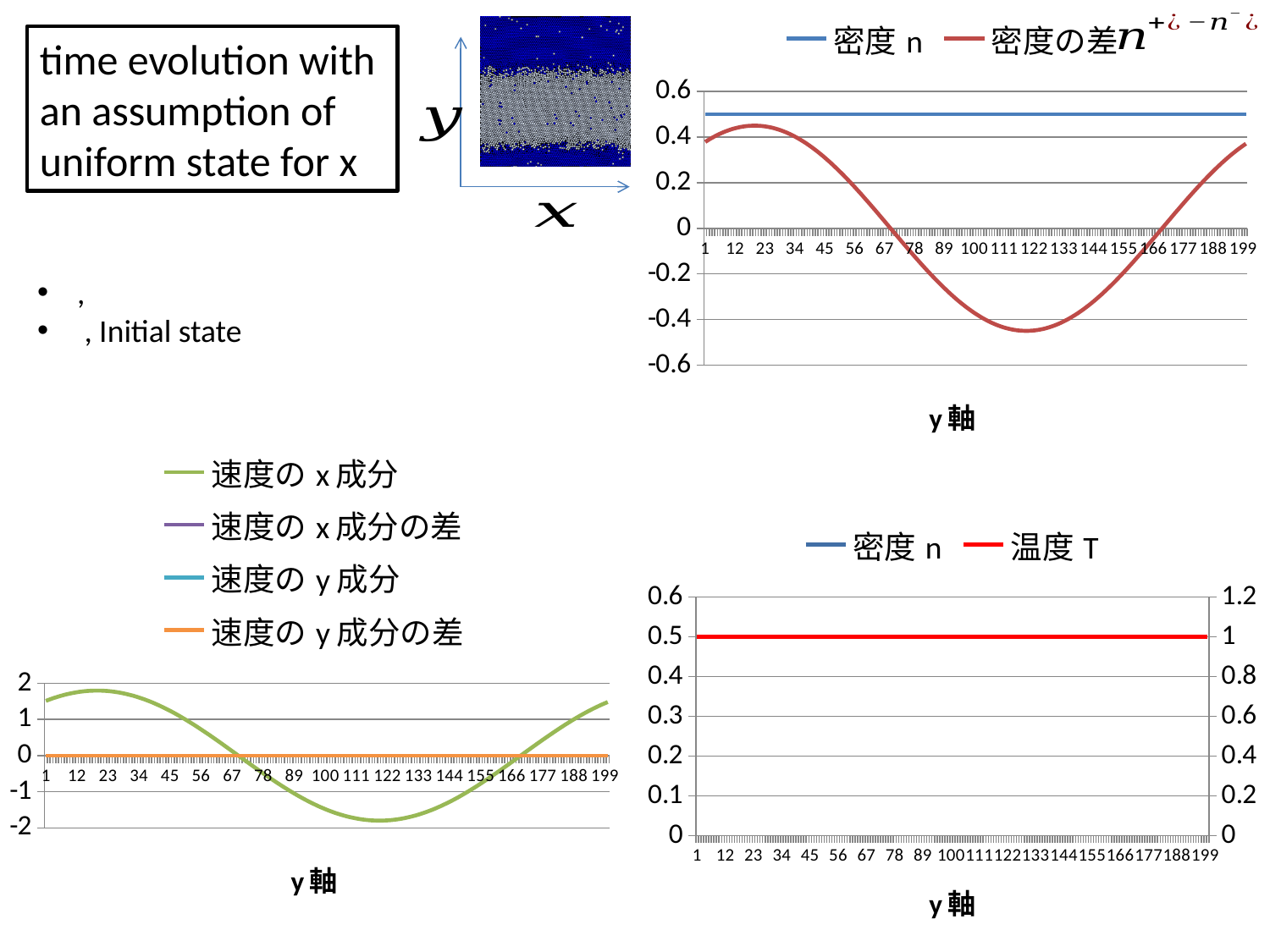
What kind of chart is the top-right chart? line chart In the bottom-left chart, is the value of 速度の x 成分 at x = 122 greater or less than -1? less How many series does the legend of the bottom-left chart list? 4 In the top-right chart, is the value of 密度 n greater or less than 0.4? greater What is the x-axis title of the bottom-left chart? y軸 How many series does the legend of the bottom-right chart list? 2 In the top-right chart, does the 密度の差 series rise or fall between x = 23 and x = 122? fall In the top-right chart, is the value of 密度の差 at x = 122 greater or less than -0.4? less In the bottom-right chart, what is the value of 密度 n (read on the left axis)? 0.5 How many series does the legend of the top-right chart list? 2 In the bottom-right chart, what is the value of 温度 T (read on the right axis)? 1